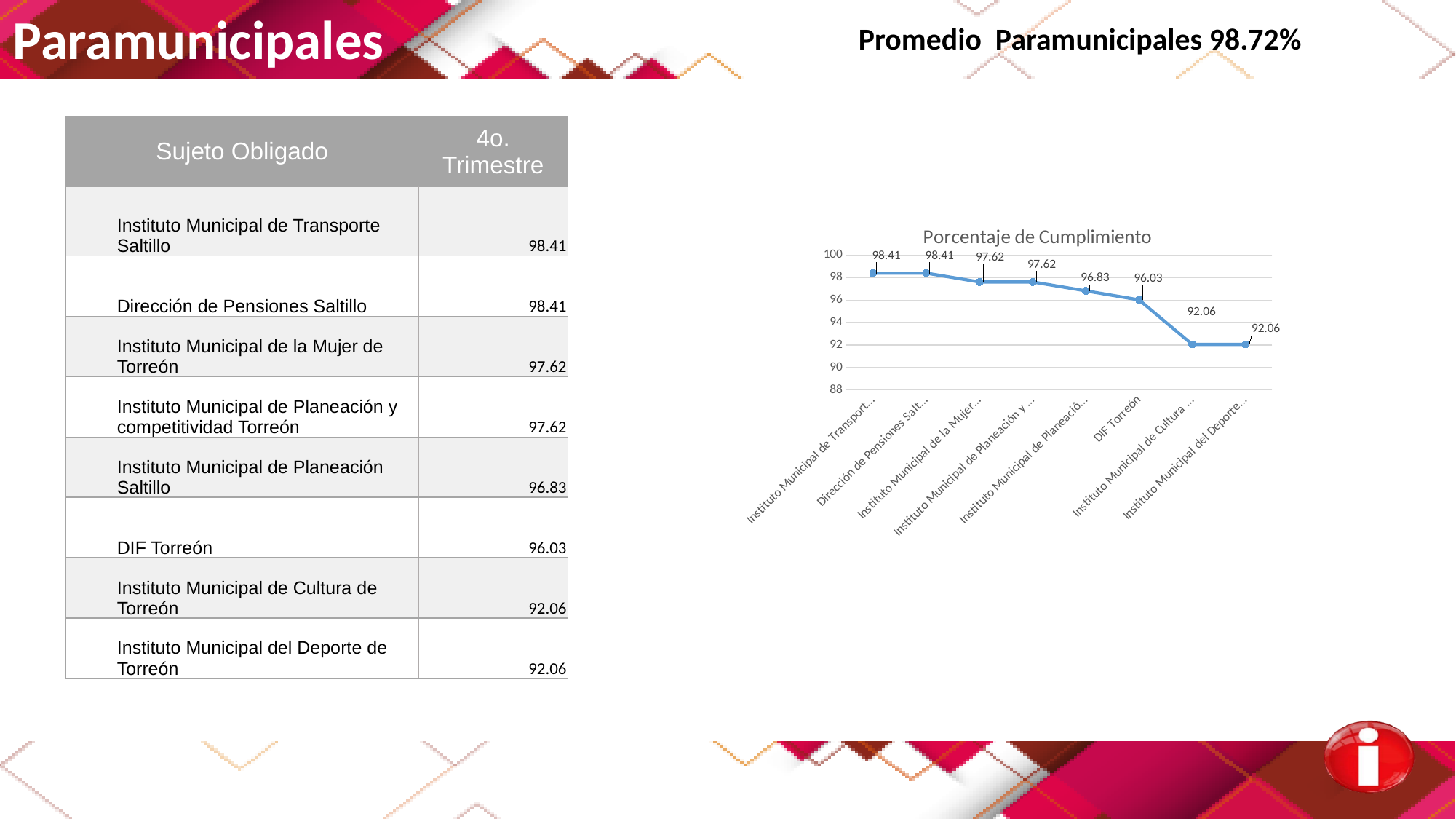
Which is larger, the value for Instituto Municipal de la Mujer de Torreón or the value for DIF Torreón? Instituto Municipal de la Mujer de Torreón Do the values rise or fall moving from left to right along the x axis? fall What is the highest value shown on the line chart? 98.41 What type of chart is shown on the slide? line chart What is the lowest value shown on the line chart? 92.06 What is the title of the chart? Porcentaje de Cumplimiento How many data points are plotted on the line chart? 8 What is the value plotted for DIF Torreón? 96.03 What is the difference between the value for DIF Torreón and the value for Instituto Municipal de Cultura de Torreón? 3.97 What is the value plotted for Dirección de Pensiones Saltillo? 98.41 What is the value plotted for Instituto Municipal de Planeación Saltillo? 96.83 Is the value for Instituto Municipal del Deporte de Torreón greater or less than 94? less